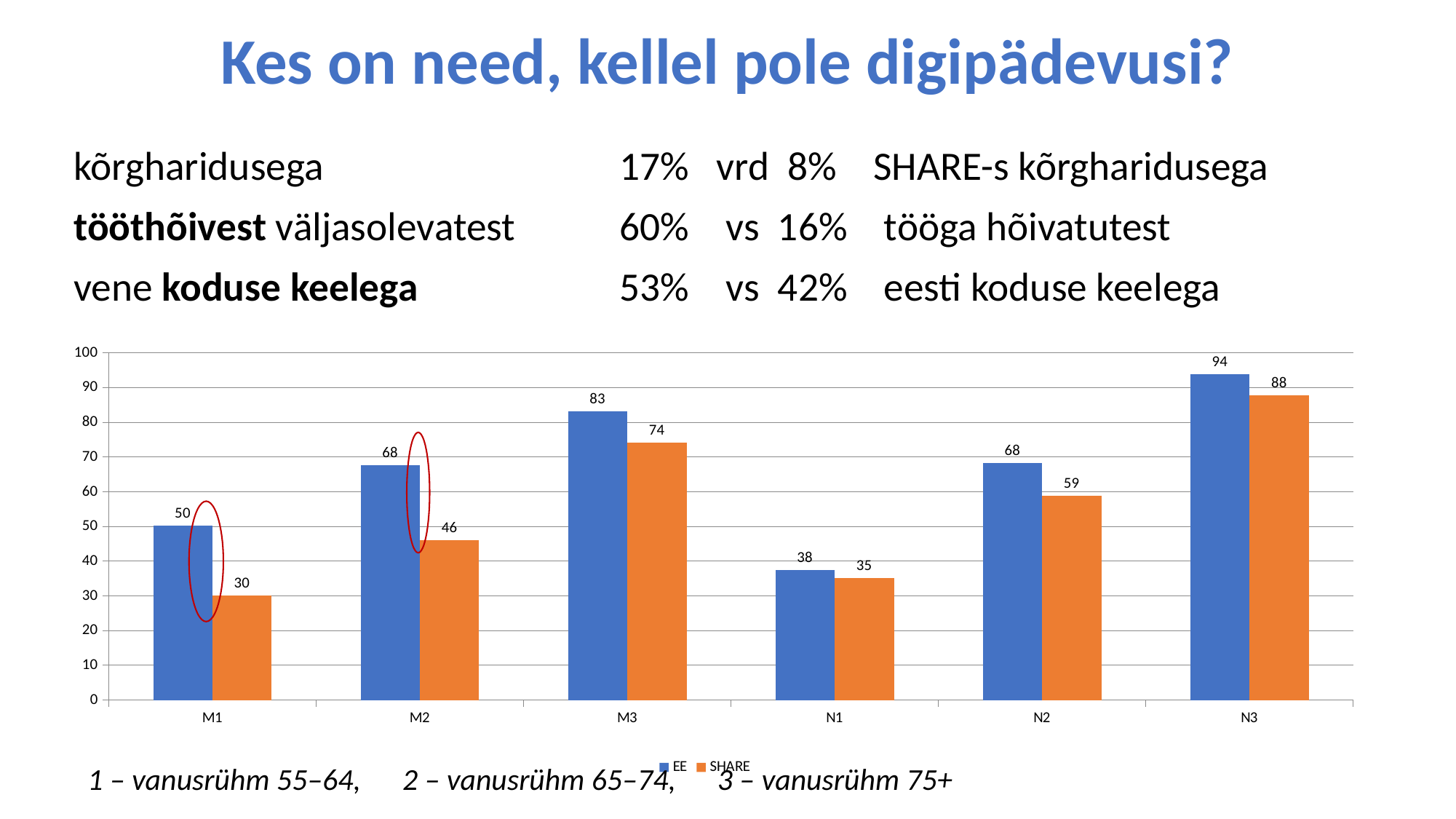
How many categories are shown on the x axis? 6 Which series is shown in orange? SHARE What is the difference between the EE values for N3 and N1? 56 What is the SHARE value for N2? 59 What is the difference between the EE and SHARE values for M2? 22 What kind of chart is shown on the slide? bar chart How many series does the legend list? 2 Which category has the highest EE value? N3 What is the SHARE value for M1? 30 Which category has the lowest SHARE value? M1 Which is larger for N1, the EE value or the SHARE value? EE What is the EE value for M3? 83